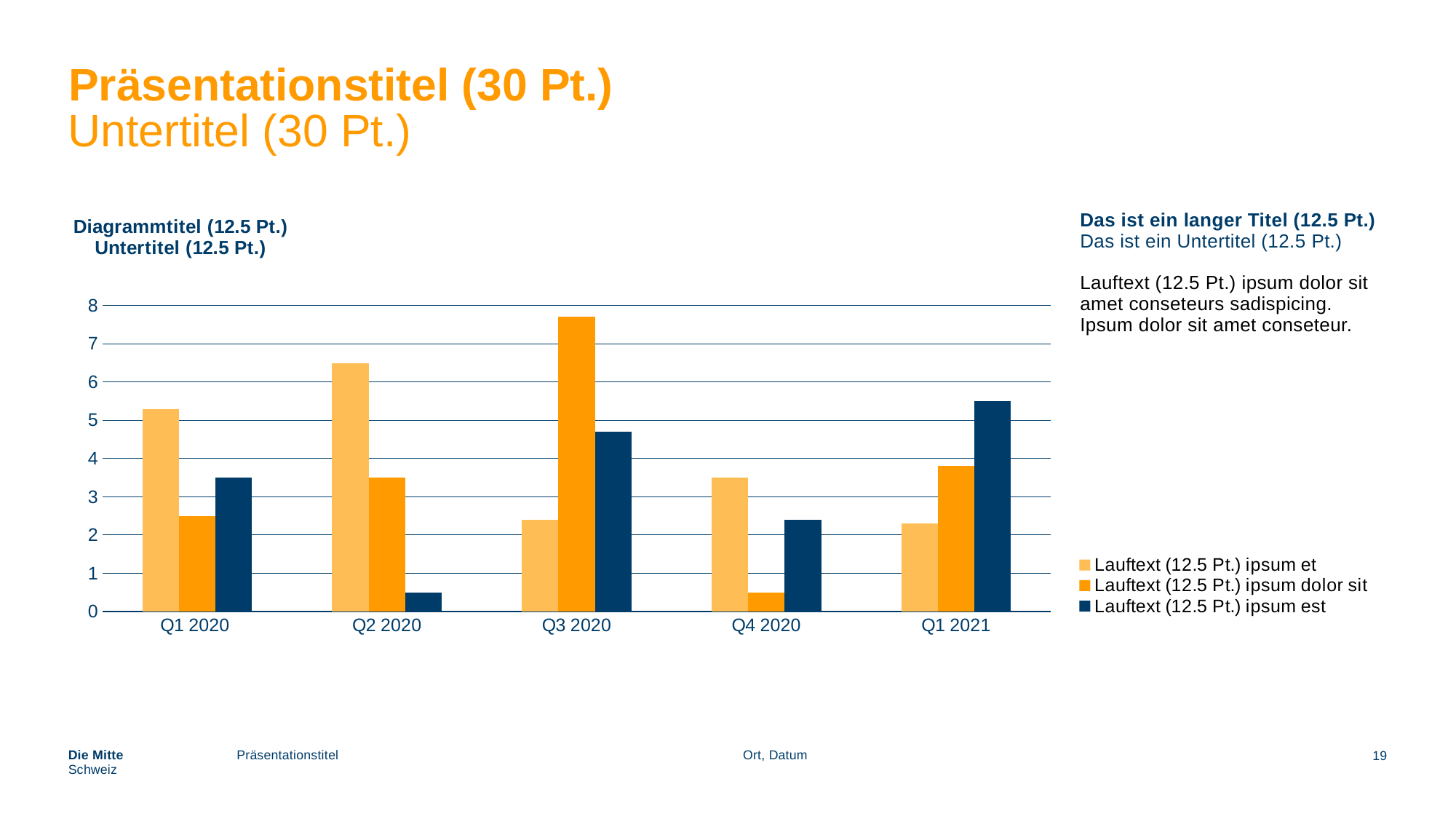
In which category is the 'Lauftext (12.5 Pt.) ipsum est' series lowest? Q2 2020 Is the value for 'Lauftext (12.5 Pt.) ipsum et' in Q1 2020 greater or less than 4? greater How many categories are shown on the x axis of the chart? 5 What colour represents the 'Lauftext (12.5 Pt.) ipsum est' series in the legend? dark blue What kind of chart is shown on the slide? bar chart In which category is the 'Lauftext (12.5 Pt.) ipsum dolor sit' series lowest? Q4 2020 How many series does the chart legend list? 3 Does the 'Lauftext (12.5 Pt.) ipsum dolor sit' series rise or fall from Q1 2020 to Q3 2020? rise Which category has the tallest bar in the whole chart? Q3 2020 In which category is the 'Lauftext (12.5 Pt.) ipsum et' series highest? Q2 2020 In Q1 2021, which is larger: 'Lauftext (12.5 Pt.) ipsum est' or 'Lauftext (12.5 Pt.) ipsum dolor sit'? Lauftext (12.5 Pt.) ipsum est Is the value for 'Lauftext (12.5 Pt.) ipsum dolor sit' in Q3 2020 greater or less than 7? greater